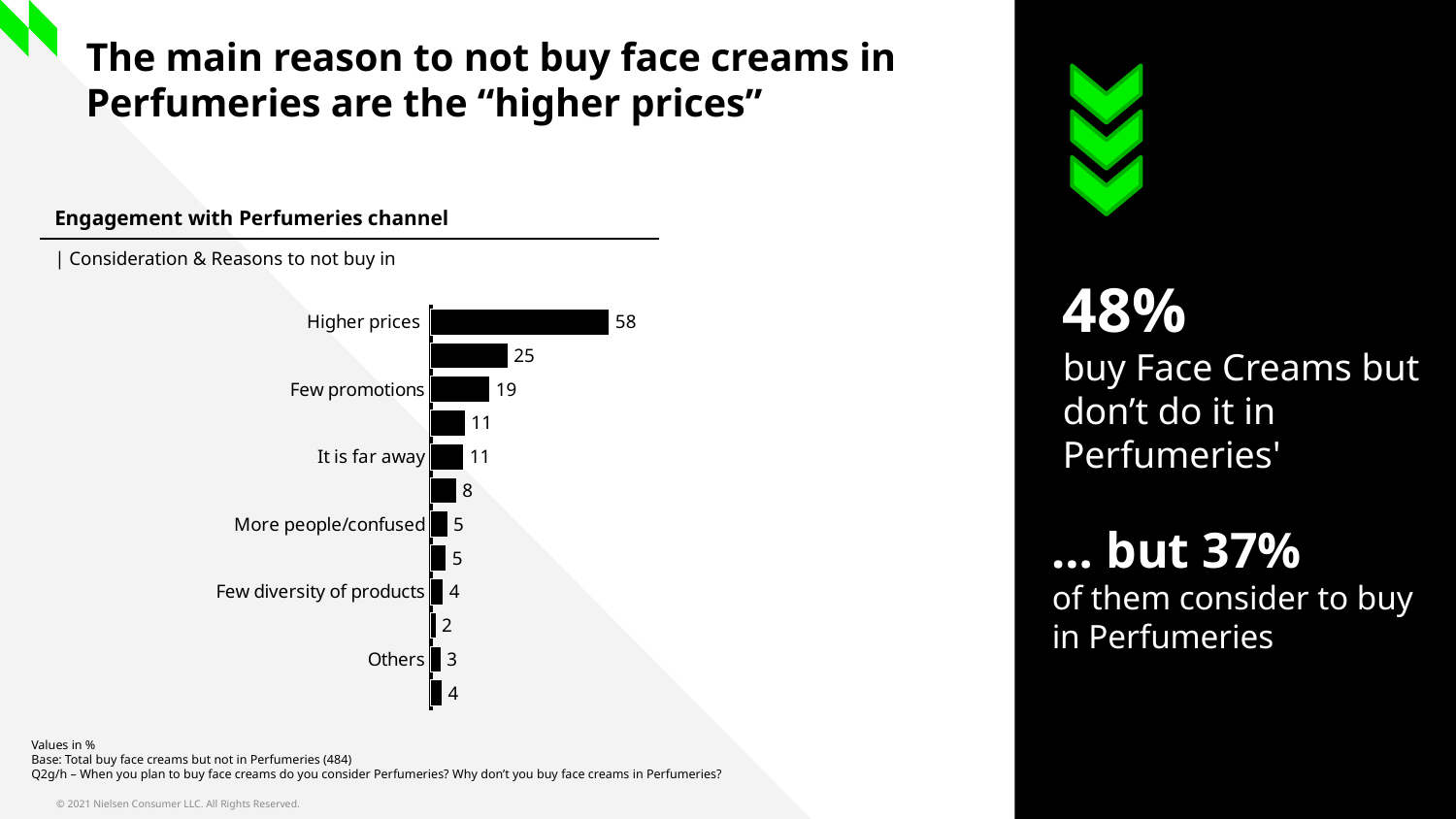
How many bars are plotted in the chart? 12 What is the value for Higher prices? 58 What is the value for Others? 3 What is the title of the chart section? Engagement with Perfumeries channel Which reason has the highest value? Higher prices Which is larger, the value for Few promotions or the value for It is far away? Few promotions What is the value for It is far away? 11 What is the value for Few diversity of products? 4 What is the difference between the values for Higher prices and Few promotions? 39 What is the value for More people/confused? 5 What kind of chart is shown on the slide? Bar chart What is the value for Few promotions? 19